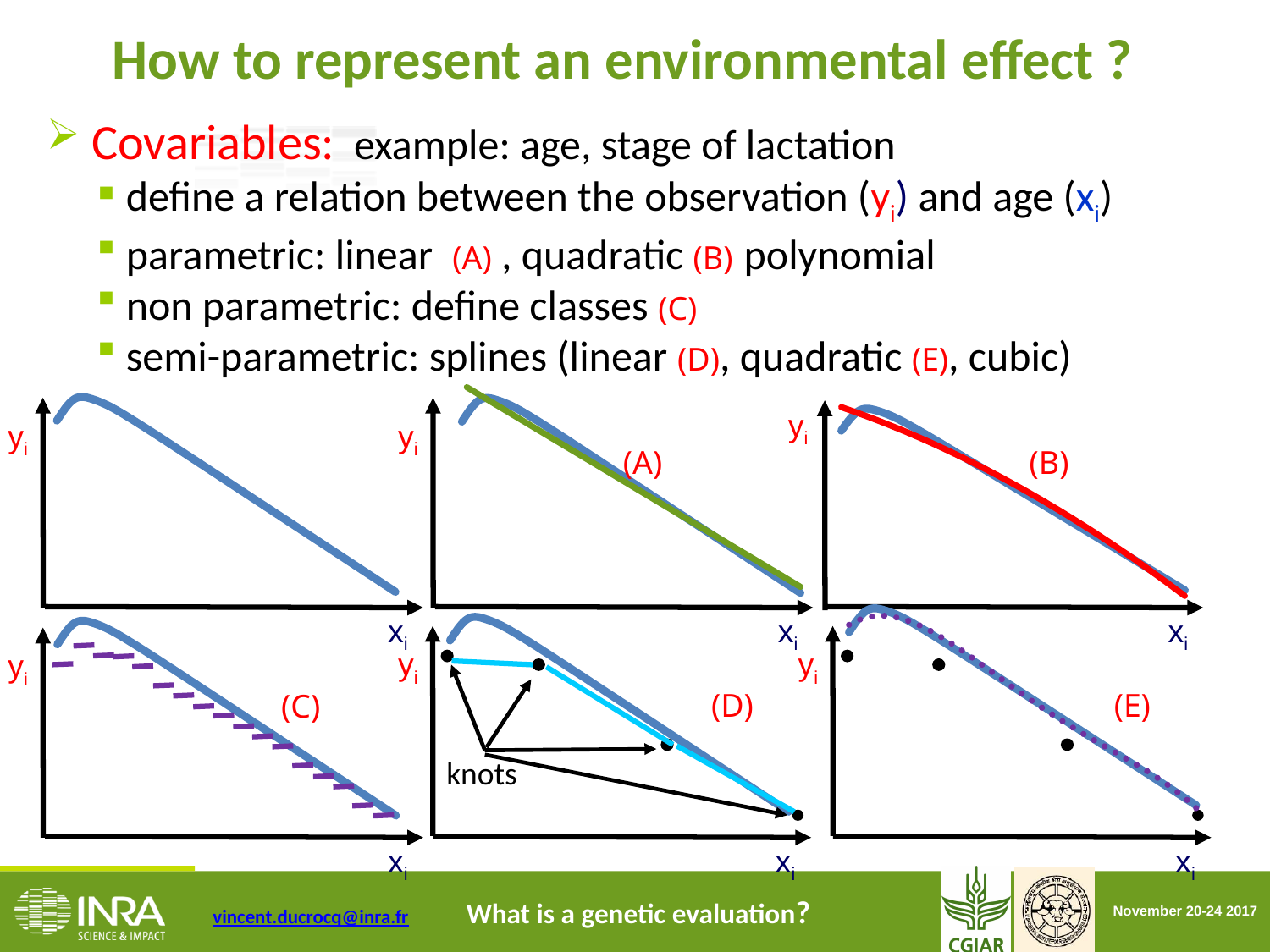
In plot (C), do the purple class steps rise or fall as x_i increases? fall In the top-left plot, does the blue curve mainly rise or fall as x_i increases? fall In plot (E), does the dotted purple curve rise or fall overall along the x axis? fall In plot (D), how many knots (black dots) are marked? 4 How many plots are shown on the slide? 6 What is the label of the vertical axis in the plots? y_i What colour is the fitted line in plot (A)? green What kind of chart are the plots on the slide? line chart